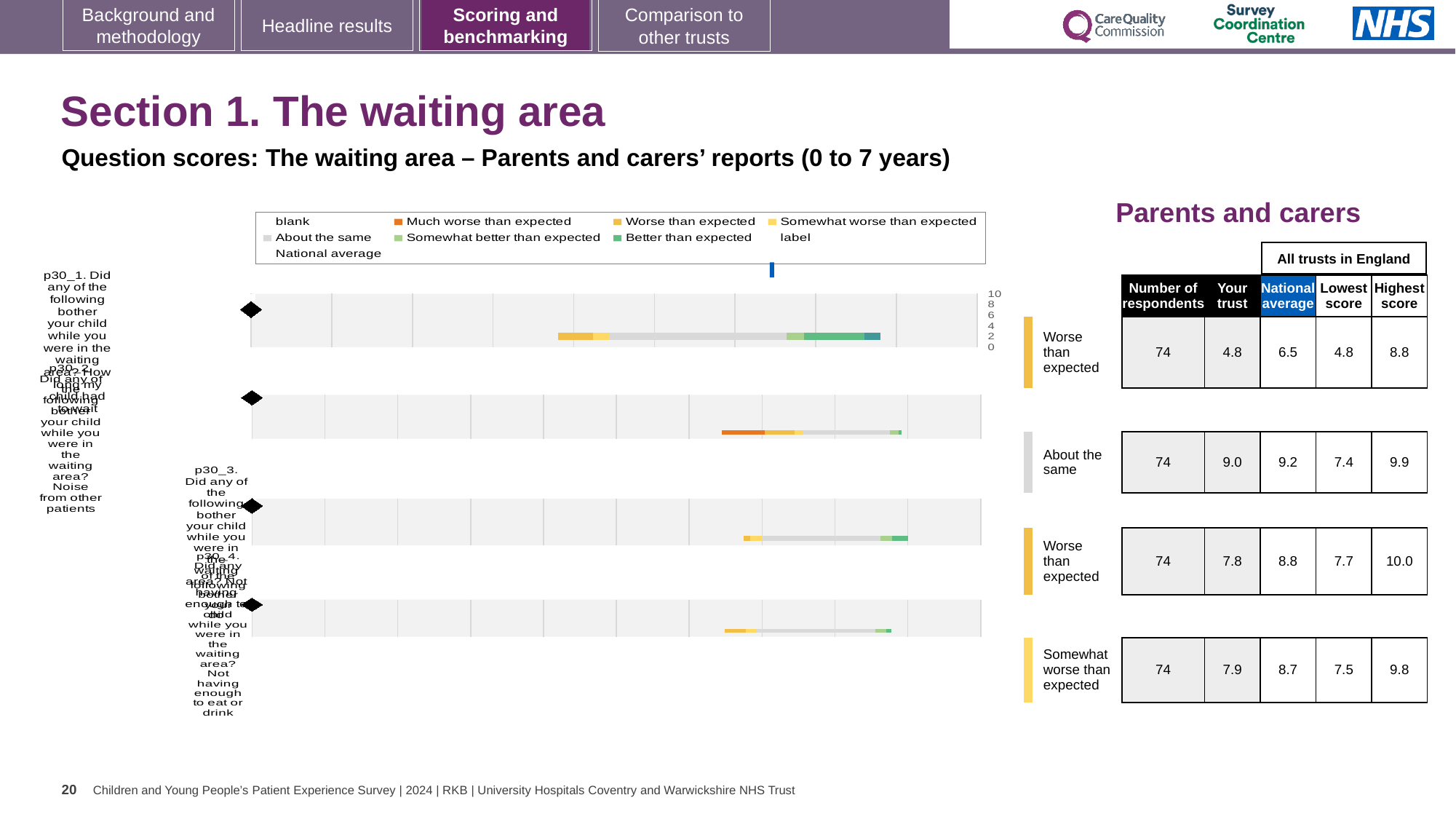
In the table, what is the difference between the Highest score and the Lowest score in the first row? 4.0 In the table, how many respondents are listed for the fourth row (Somewhat worse than expected)? 74 In the table, what is the National average for the second row (About the same)? 9.2 In the table, what is the 'Your trust' score for the first row (Worse than expected)? 4.8 In the table, what is the Highest score for the third row? 10.0 How many question bars are plotted in the chart? 4 In the table's second row, which is larger: the 'Your trust' score or the National average? National average What kind of chart is shown on the slide? bar chart How many entries does the chart legend list? 9 What colour represents 'Much worse than expected' in the chart legend? orange What colour represents 'About the same' in the chart legend? grey Which row of the table has the highest 'Your trust' score? About the same (9.0)